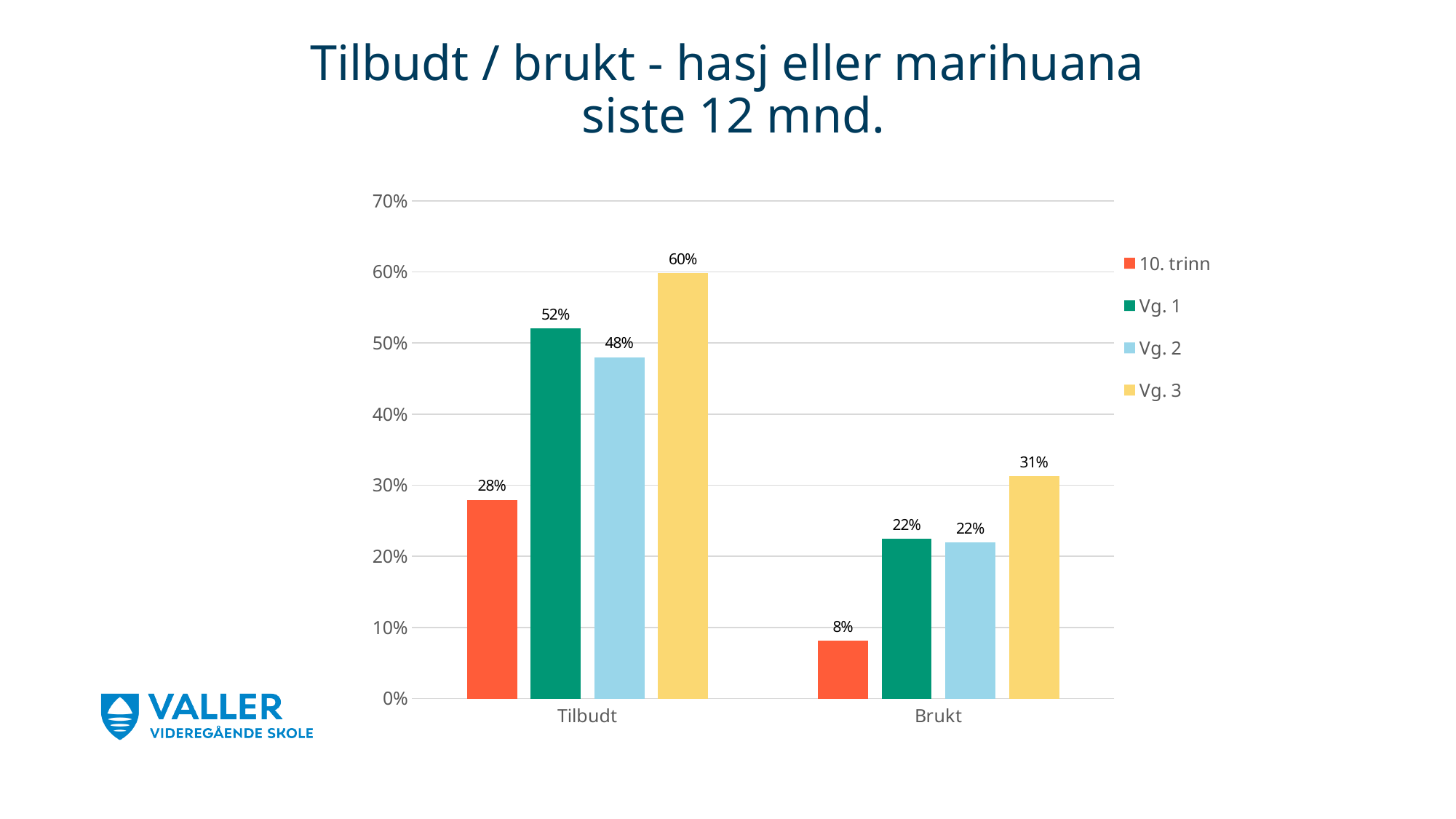
Which is larger: the Vg. 3 value for Brukt or the 10. trinn value for Tilbudt? Vg. 3 value for Brukt How many series does the legend list? 4 What colour are the bars for Vg. 1? Green What is the title of the chart? Tilbudt / brukt - hasj eller marihuana siste 12 mnd. How many categories are shown on the x axis? 2 What is the value for Vg. 2 in the Tilbudt category? 48% Which series has the lowest value in the Brukt category? 10. trinn What is the difference between the Vg. 1 value for Tilbudt and the Vg. 1 value for Brukt? 30% What is the value for 10. trinn in the Brukt category? 8% What kind of chart is shown on the slide? Bar chart Which series has the highest value in the Tilbudt category? Vg. 3 What is the value for Vg. 3 in the Tilbudt category? 60%